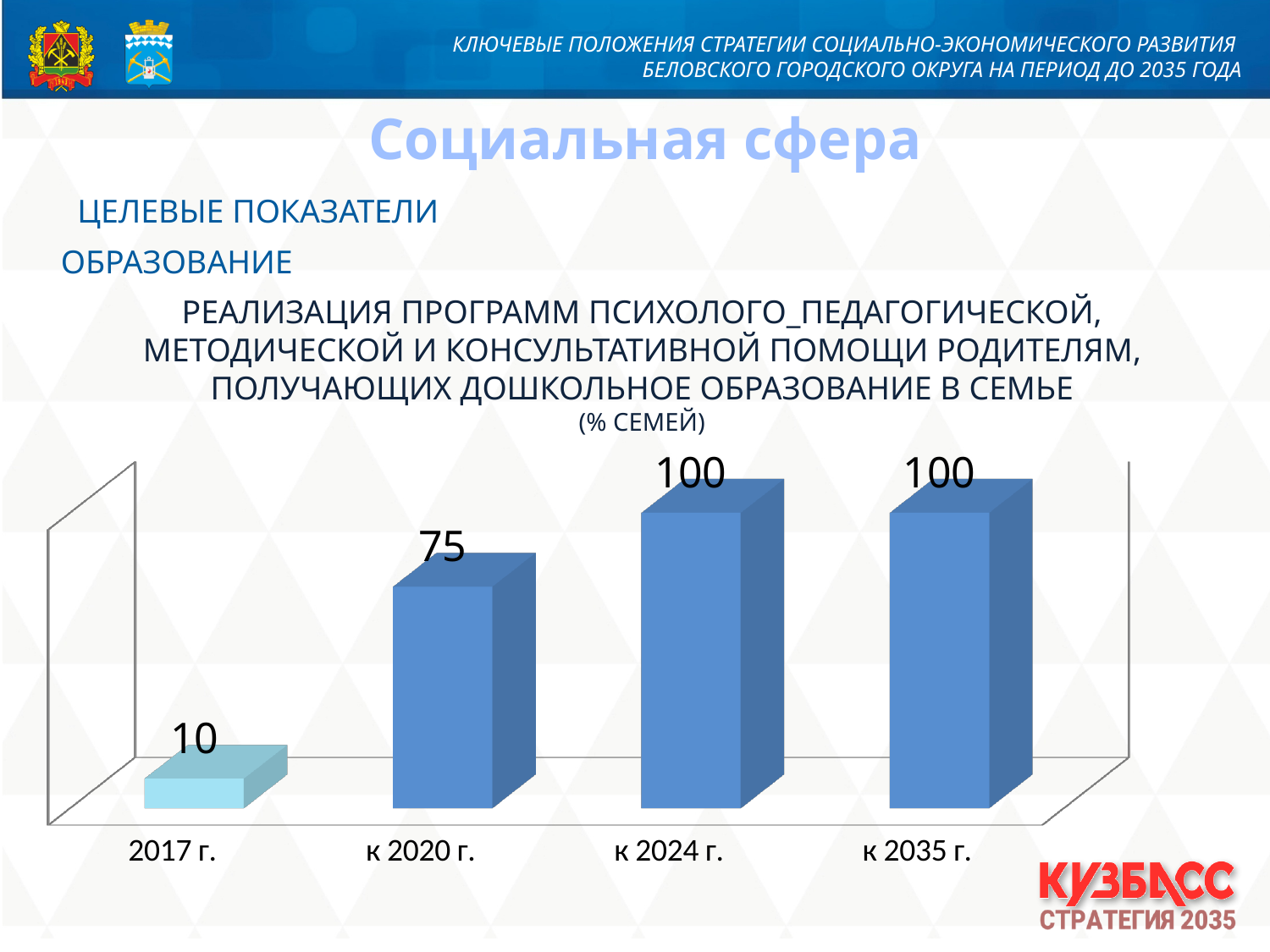
What is the value for к 2035 г.? 100 What unit is given in parentheses under the chart title? % семей What is the value for к 2020 г.? 75 Which category has the lowest value? 2017 г. What is the difference between the values for к 2024 г. and к 2020 г.? 25 Which is larger, the value for 2017 г. or the value for к 2020 г.? к 2020 г. What is the difference between the values for к 2020 г. and 2017 г.? 65 How many categories are shown on the x axis? 4 Do the values rise or fall from 2017 г. to к 2024 г.? rise What is the value for к 2024 г.? 100 What is the value for 2017 г.? 10 What kind of chart is shown on the slide? bar chart